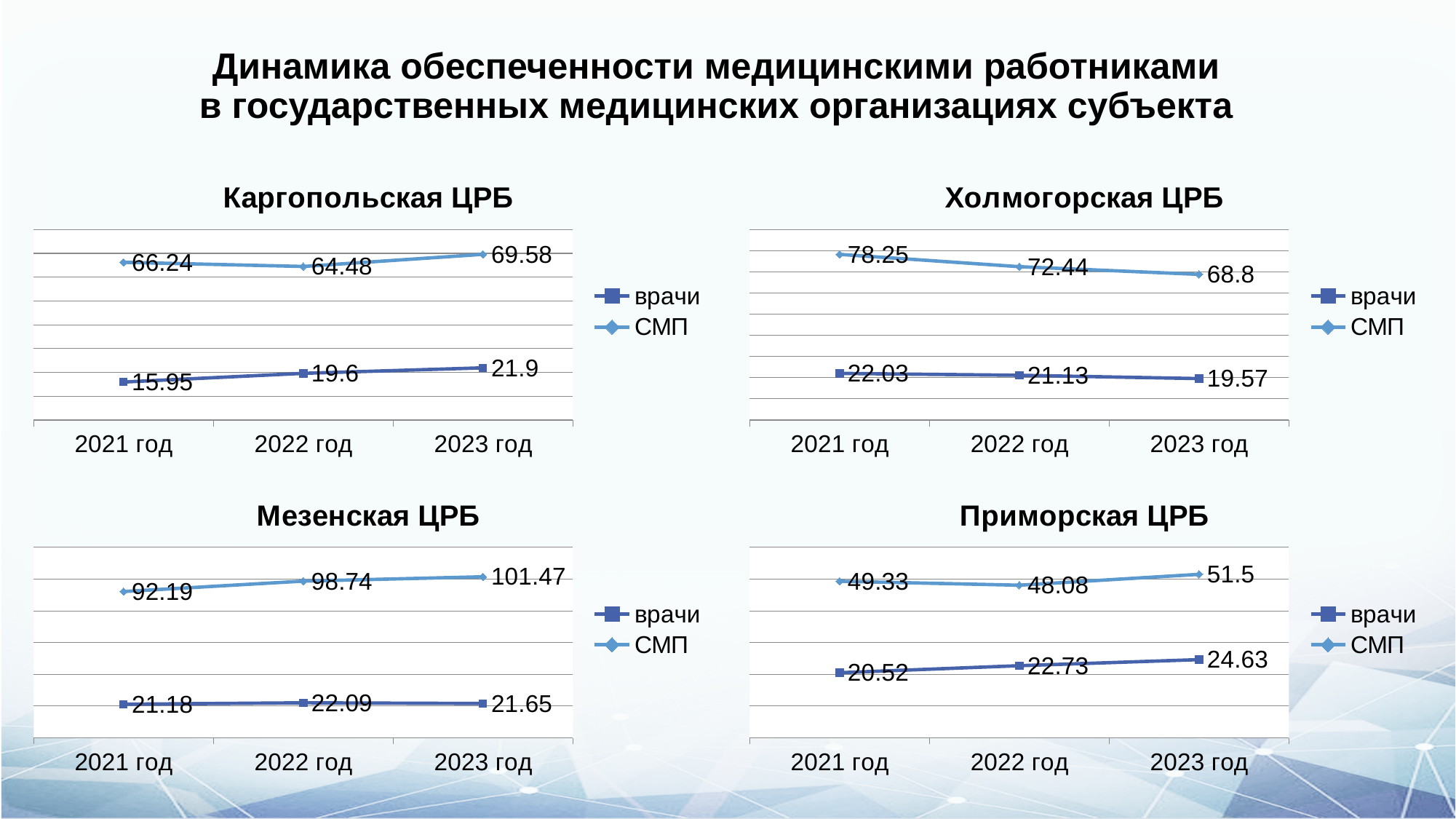
In the Холмогорская ЦРБ chart, which year has the lowest value for СМП? 2023 год In the Холмогорская ЦРБ chart, what is the difference between the СМП values for 2021 год and 2023 год? 9.45 In the Каргопольская ЦРБ chart, what is the value for врачи in 2023 год? 21.9 In the Холмогорская ЦРБ chart, do the врачи values rise or fall from 2021 год to 2023 год? fall In the Холмогорская ЦРБ chart, what is the value for СМП in 2021 год? 78.25 In the Приморская ЦРБ chart, what is the difference between the врачи values for 2023 год and 2021 год? 4.11 In the Мезенская ЦРБ chart, which year has the highest value for врачи? 2022 год In the Мезенская ЦРБ chart, what is the value for СМП in 2023 год? 101.47 In the Каргопольская ЦРБ chart, which is larger: the СМП value for 2021 год or for 2022 год? 2021 год How many series does the legend of the Приморская ЦРБ chart list? 2 What kind of chart is the Мезенская ЦРБ chart? line chart In the Приморская ЦРБ chart, what is the value for врачи in 2022 год? 22.73